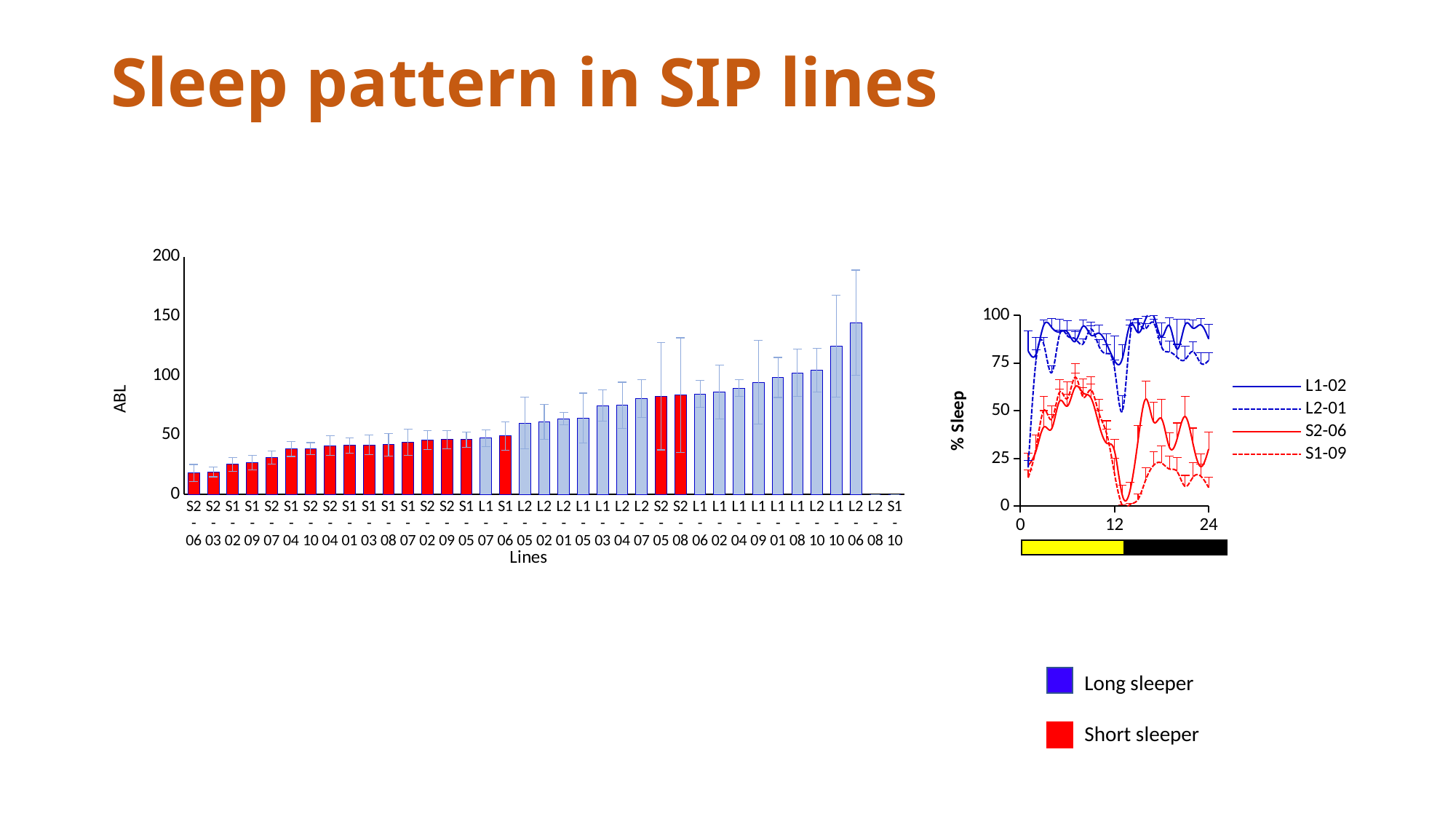
What is the label of the y axis on the right line chart? % Sleep In the left bar chart, which line has the highest ABL value? L2-06 In the left bar chart, which has the larger ABL value, L2-06 or S2-06? L2-06 In the left bar chart, which has the larger ABL value, L1-10 or L1-02? L1-10 What is the label of the x axis on the left bar chart? Lines In the left bar chart, is the value for L2-06 greater or less than 100? greater What kind of chart is the right chart with the % Sleep axis? line chart In the left bar chart, is the value for S2-05 greater or less than 50? greater In the left bar chart, is the value for L1-10 greater or less than 100? greater How many series does the legend of the right line chart list? 4 What kind of chart is the left chart with the ABL axis? bar chart